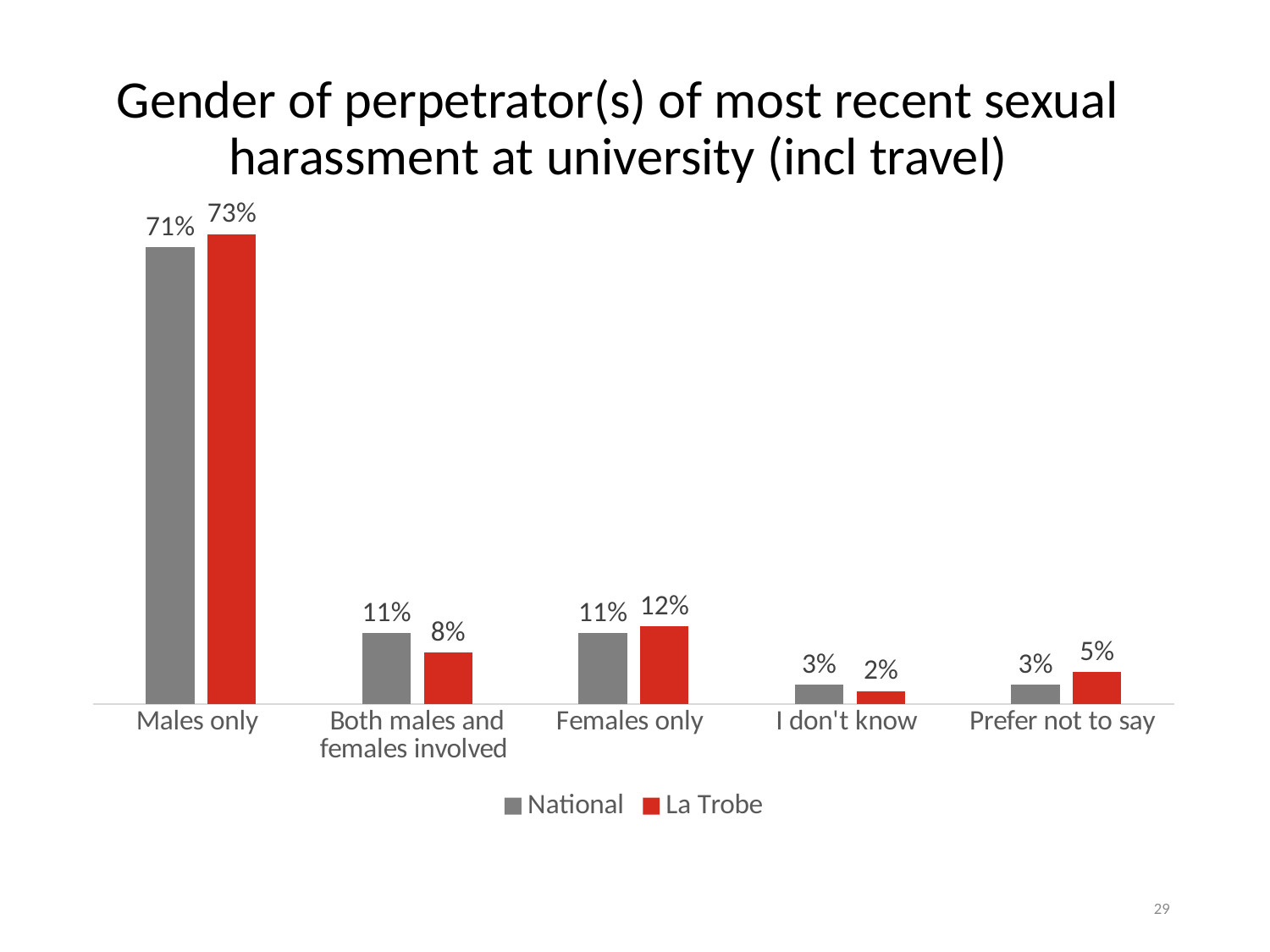
What is the difference between the National and La Trobe values for Both males and females involved? 3% What is the difference between the La Trobe and National values for Females only? 1% What kind of chart is shown on the slide? Bar chart Which category has the highest La Trobe value? Males only What is the La Trobe value for Both males and females involved? 8% Which colour represents the La Trobe series? Red What is the La Trobe value for Prefer not to say? 5% How many series does the legend list? 2 What is the National value for Males only? 71% Which category has the lowest La Trobe value? I don't know How many categories are shown on the x axis? 5 Which is larger for Prefer not to say, the National value or the La Trobe value? La Trobe